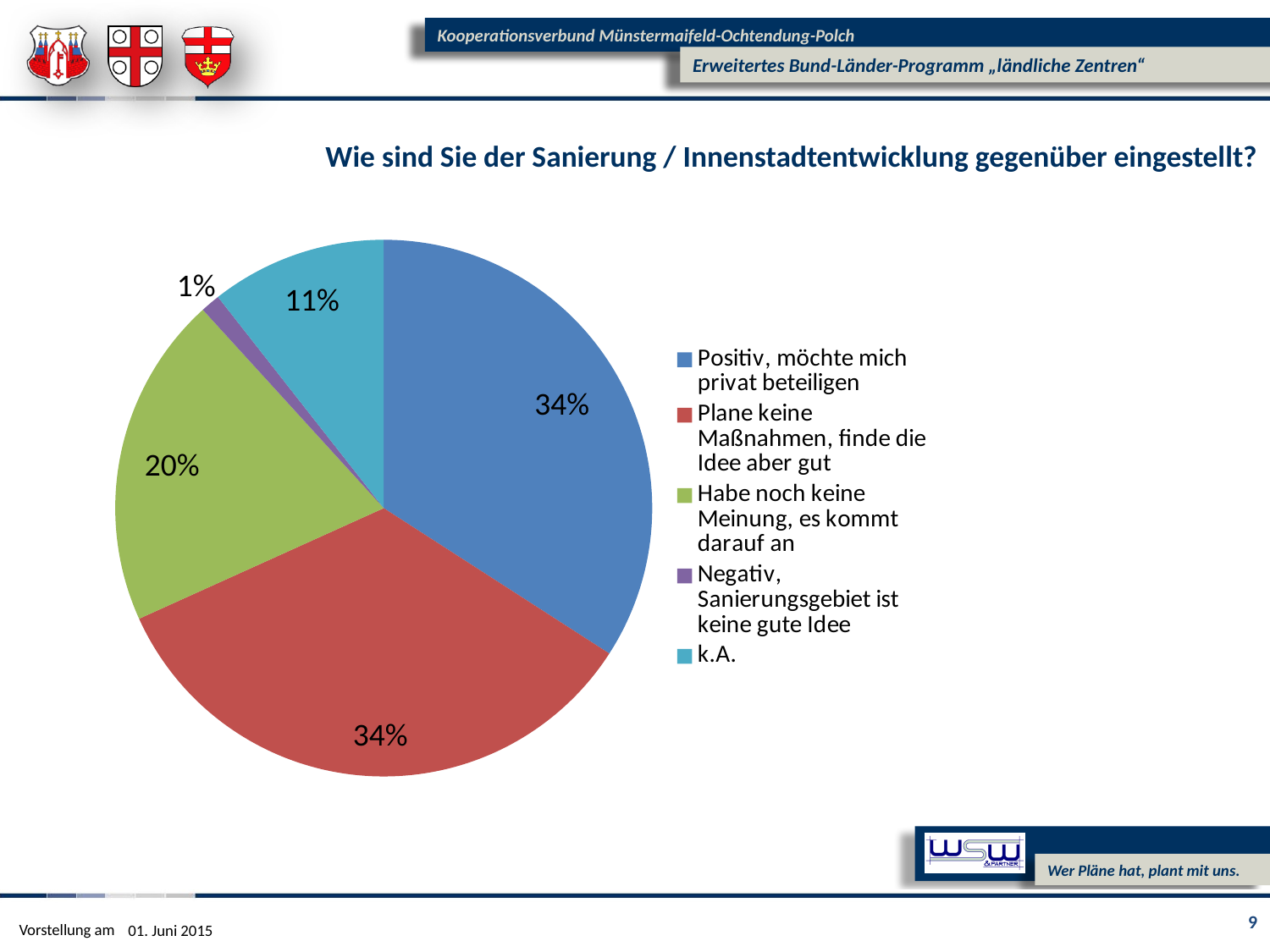
What colour is the slice for "k.A." in the pie chart? light blue Which slice is larger: "Habe noch keine Meinung, es kommt darauf an" or "k.A."? Habe noch keine Meinung, es kommt darauf an What share of the pie is labelled "Negativ, Sanierungsgebiet ist keine gute Idee"? 1% What is the title of the question shown above the pie chart? Wie sind Sie der Sanierung / Innenstadtentwicklung gegenüber eingestellt? What share of the pie is labelled "Plane keine Maßnahmen, finde die Idee aber gut"? 34% What share of the pie is labelled "Positiv, möchte mich privat beteiligen"? 34% Which category has the smallest slice of the pie? Negativ, Sanierungsgebiet ist keine gute Idee What share of the pie is labelled "Habe noch keine Meinung, es kommt darauf an"? 20% How many categories does the legend of the pie chart list? 5 What kind of chart is shown on the slide? pie chart What is the difference in percentage points between the "Habe noch keine Meinung, es kommt darauf an" slice and the "k.A." slice? 9 What share of the pie is labelled "k.A."? 11%